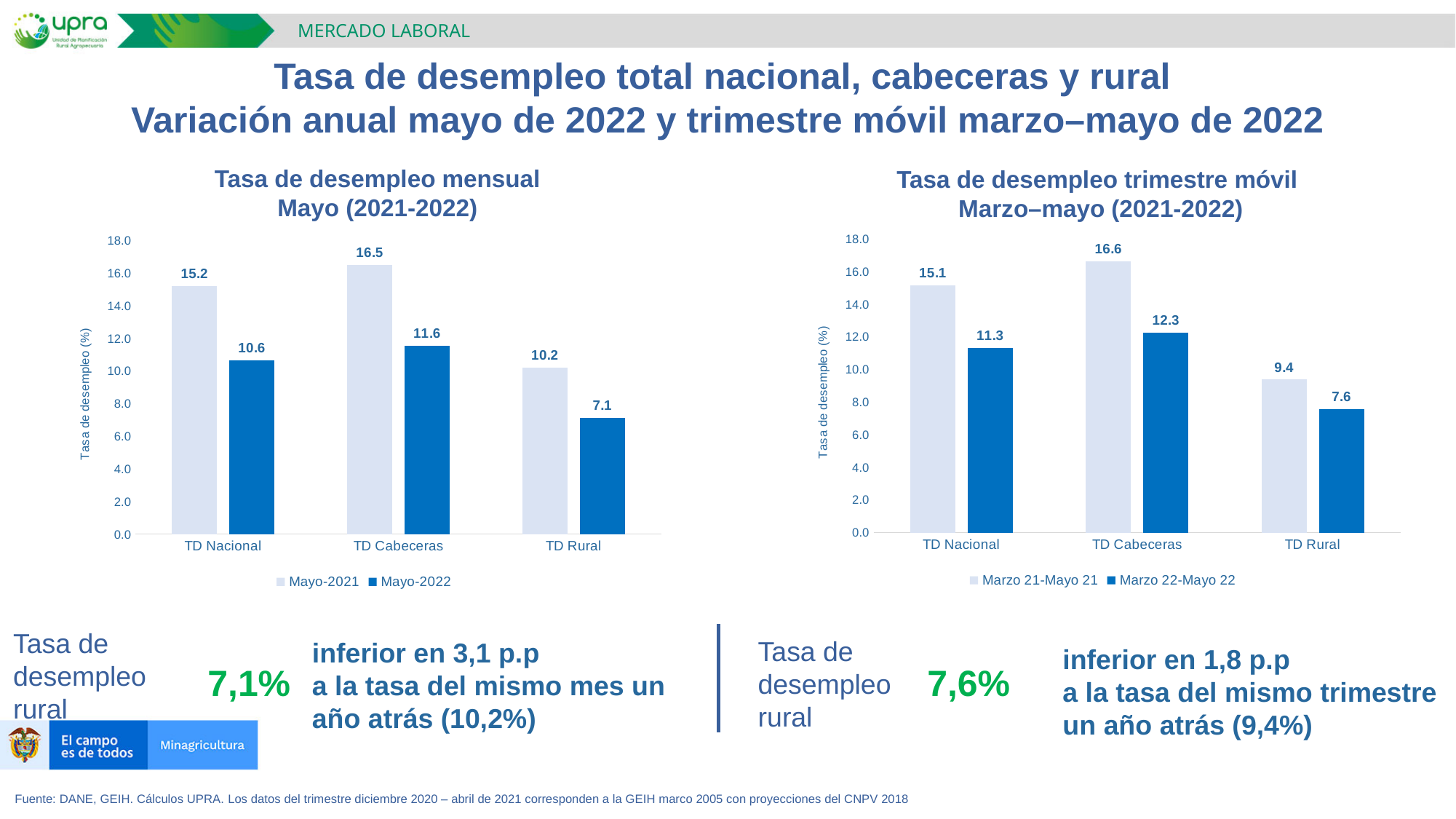
In the left chart (Tasa de desempleo mensual Mayo), what is the value for TD Cabeceras in Mayo-2021? 16.5 In the left chart (Tasa de desempleo mensual Mayo), what is the difference between the Mayo-2021 and Mayo-2022 values for TD Rural? 3.1 In the right chart (Tasa de desempleo trimestre móvil), which is larger: TD Nacional in Marzo 22-Mayo 22 or TD Rural in Marzo 21-Mayo 21? TD Nacional in Marzo 22-Mayo 22 How many categories are shown on the x axis of the left chart (Tasa de desempleo mensual Mayo)? 3 What is the y-axis label of the right chart (Tasa de desempleo trimestre móvil)? Tasa de desempleo (%) What kind of chart is the left chart (Tasa de desempleo mensual Mayo)? Bar chart In the right chart (Tasa de desempleo trimestre móvil), which category has the highest value for Marzo 21-Mayo 21? TD Cabeceras In the right chart (Tasa de desempleo trimestre móvil), what is the value for TD Rural in Marzo 22-Mayo 22? 7.6 In the left chart (Tasa de desempleo mensual Mayo), what is the value for TD Nacional in Mayo-2022? 10.6 How many series does the legend of the right chart (Tasa de desempleo trimestre móvil) list? 2 In the right chart (Tasa de desempleo trimestre móvil), what is the difference between the Marzo 21-Mayo 21 and Marzo 22-Mayo 22 values for TD Cabeceras? 4.3 In the left chart (Tasa de desempleo mensual Mayo), which category has the lowest value for Mayo-2022? TD Rural